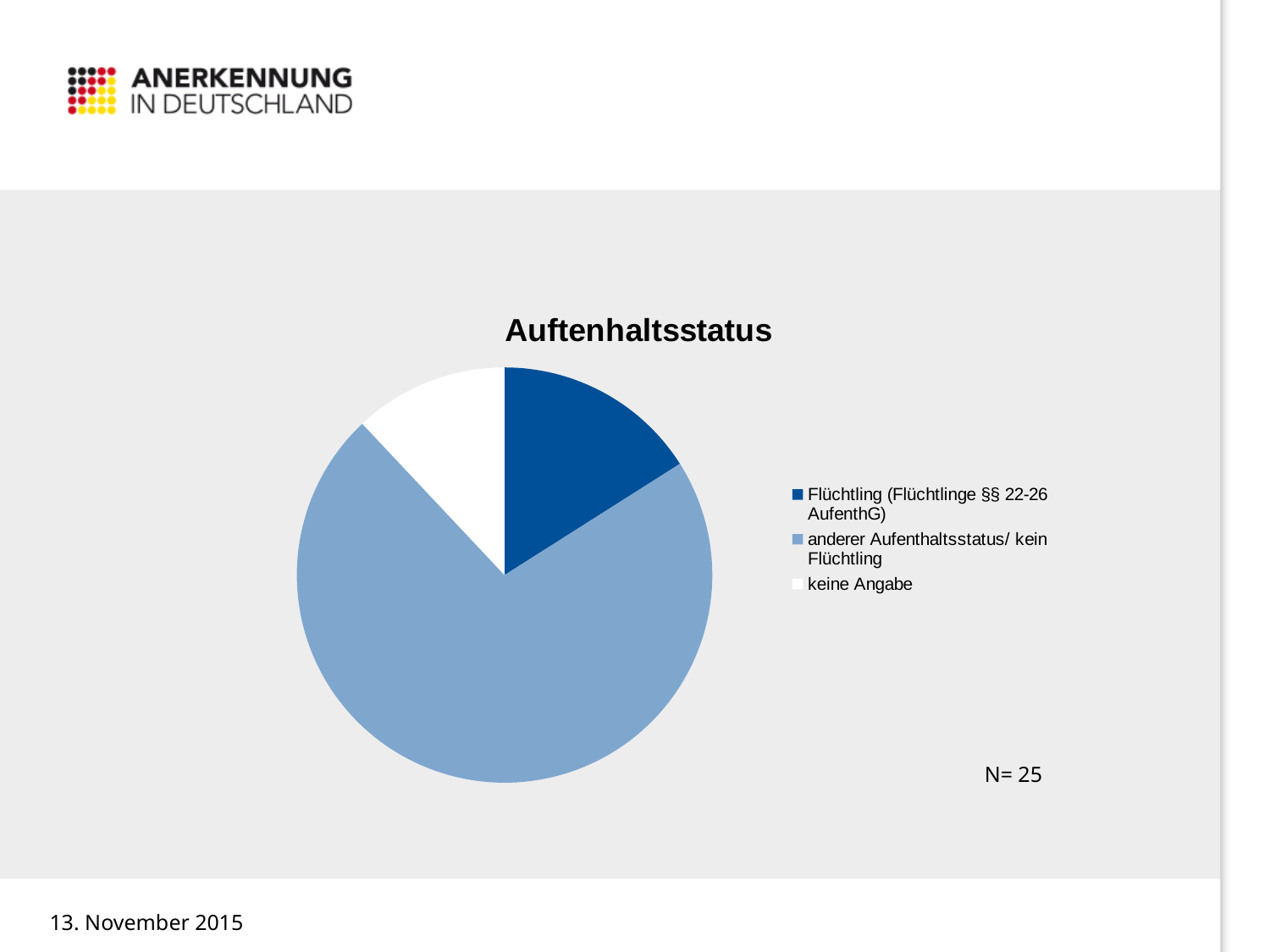
Does the 'anderer Aufenthaltsstatus/ kein Flüchtling' slice make up more or less than half of the pie? more How many entries does the legend list? 3 What sample size (N) is stated next to the chart? N= 25 How many slices does the pie chart have? 3 Which slice is larger: 'keine Angabe' or 'anderer Aufenthaltsstatus/ kein Flüchtling'? anderer Aufenthaltsstatus/ kein Flüchtling Which category has the largest slice of the pie? anderer Aufenthaltsstatus/ kein Flüchtling What is the title of the chart? Auftenhaltsstatus What kind of chart is shown on the slide? pie chart Which slice is larger: 'Flüchtling (Flüchtlinge §§ 22-26 AufenthG)' or 'anderer Aufenthaltsstatus/ kein Flüchtling'? anderer Aufenthaltsstatus/ kein Flüchtling